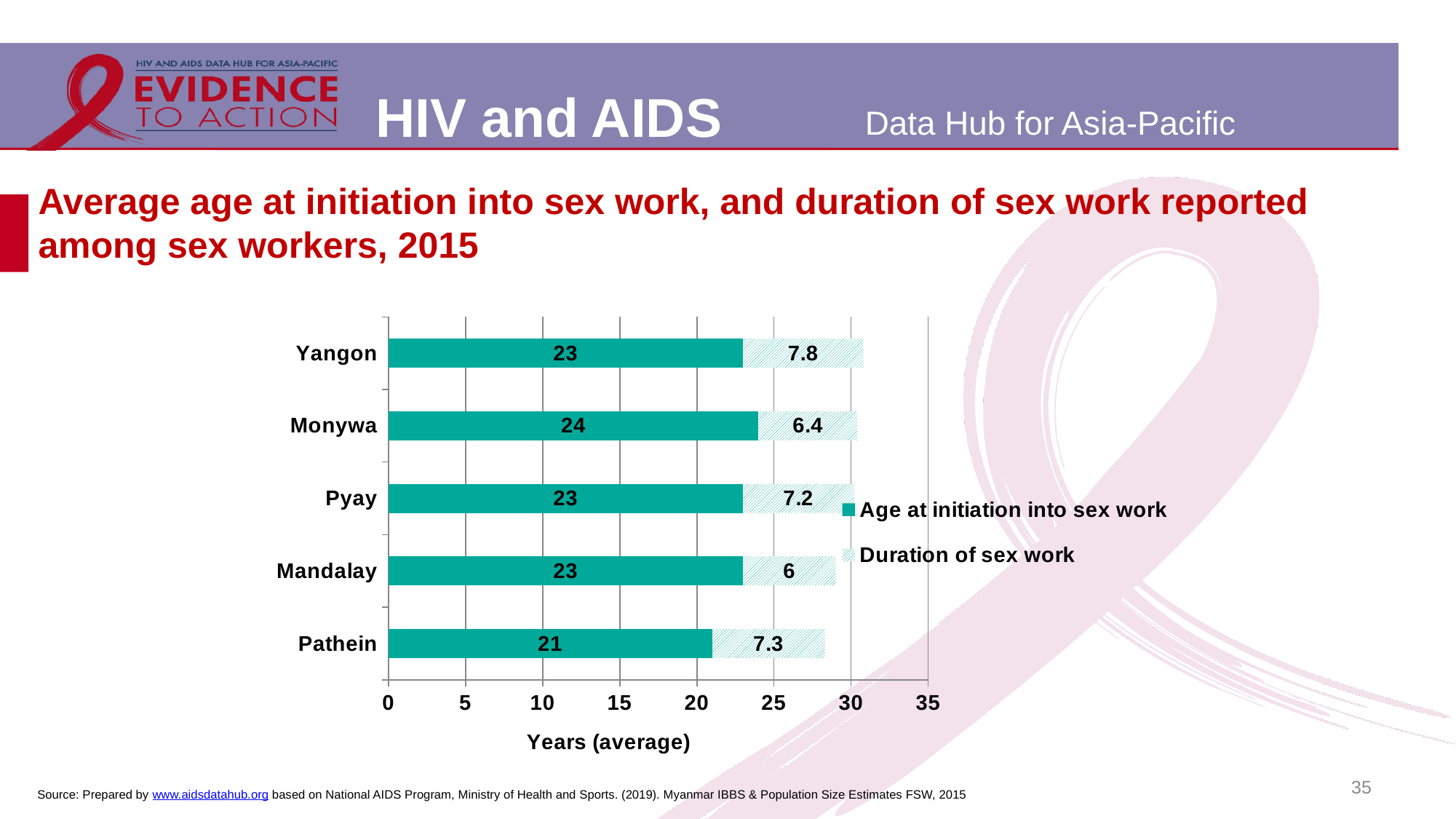
What is the average age at initiation into sex work for Monywa? 24 Which is larger, the duration of sex work in Pathein or in Pyay? Pathein What is the duration of sex work for Mandalay? 6 What type of chart is shown on the slide? Stacked bar chart What is the difference between the duration of sex work in Yangon and in Monywa? 1.4 Which city has the highest duration of sex work? Yangon Which city has the lowest duration of sex work? Mandalay What is the duration of sex work for Yangon? 7.8 Which city has the lowest average age at initiation into sex work? Pathein What is the total length of the stacked bar for Pathein (age at initiation plus duration)? 28.3 How many series does the legend list? 2 How many cities are shown on the chart? 5